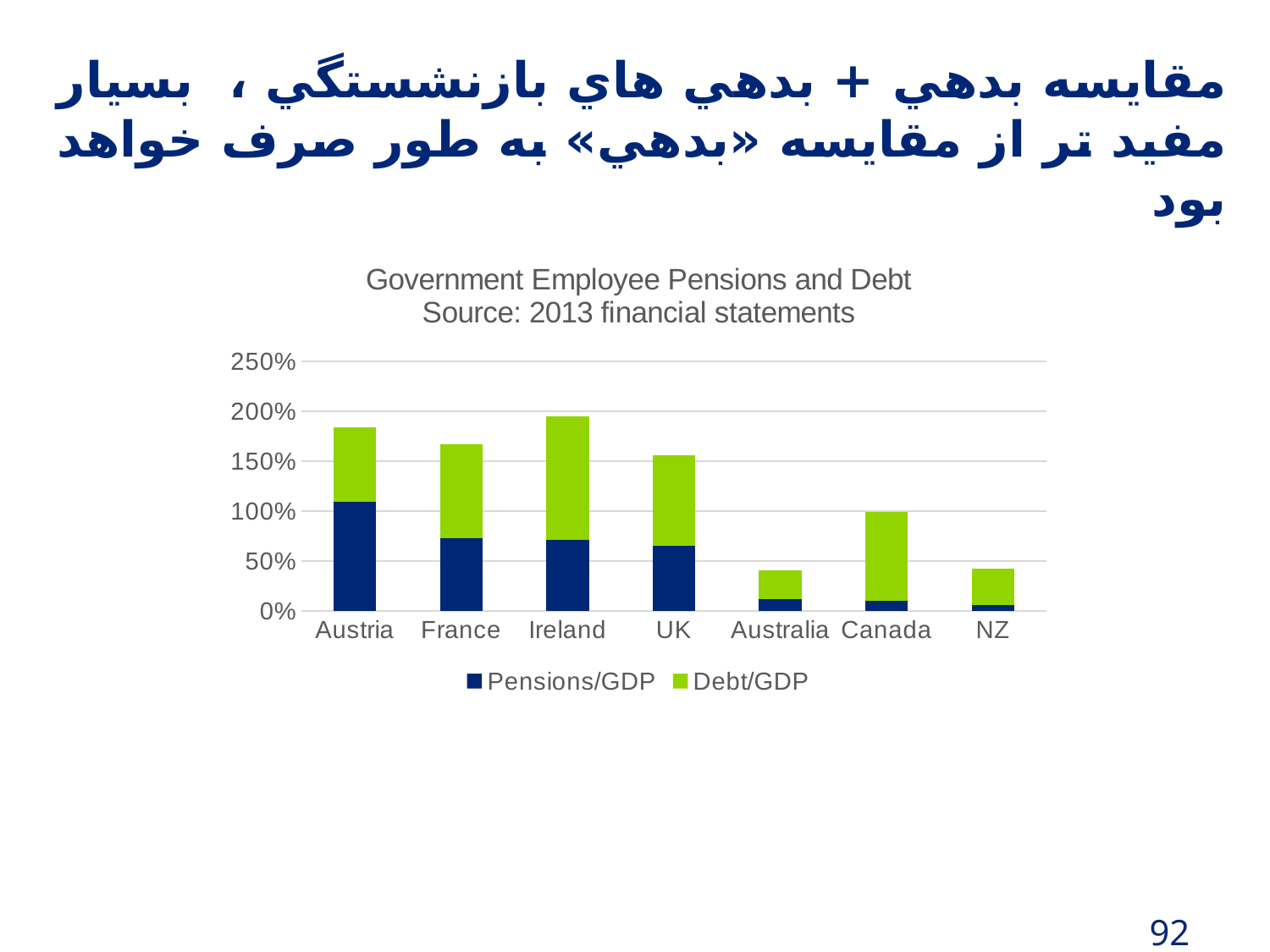
Which has the taller stacked bar, Austria or France? Austria How many countries are shown on the x axis of the chart? 7 What kind of chart is shown on the slide? stacked bar chart Which has the taller stacked bar, Canada or NZ? Canada Which country has the tallest stacked bar (highest combined Pensions/GDP and Debt/GDP)? Ireland Is the combined Pensions/GDP and Debt/GDP value for Austria greater or less than 150%? greater Which country has the highest Pensions/GDP value? Austria How many series does the chart's legend list? 2 What is the title of the chart? Government Employee Pensions and Debt Source: 2013 financial statements Is the combined Pensions/GDP and Debt/GDP value for Australia greater or less than 50%? less Is the Pensions/GDP value for Austria greater or less than 100%? greater